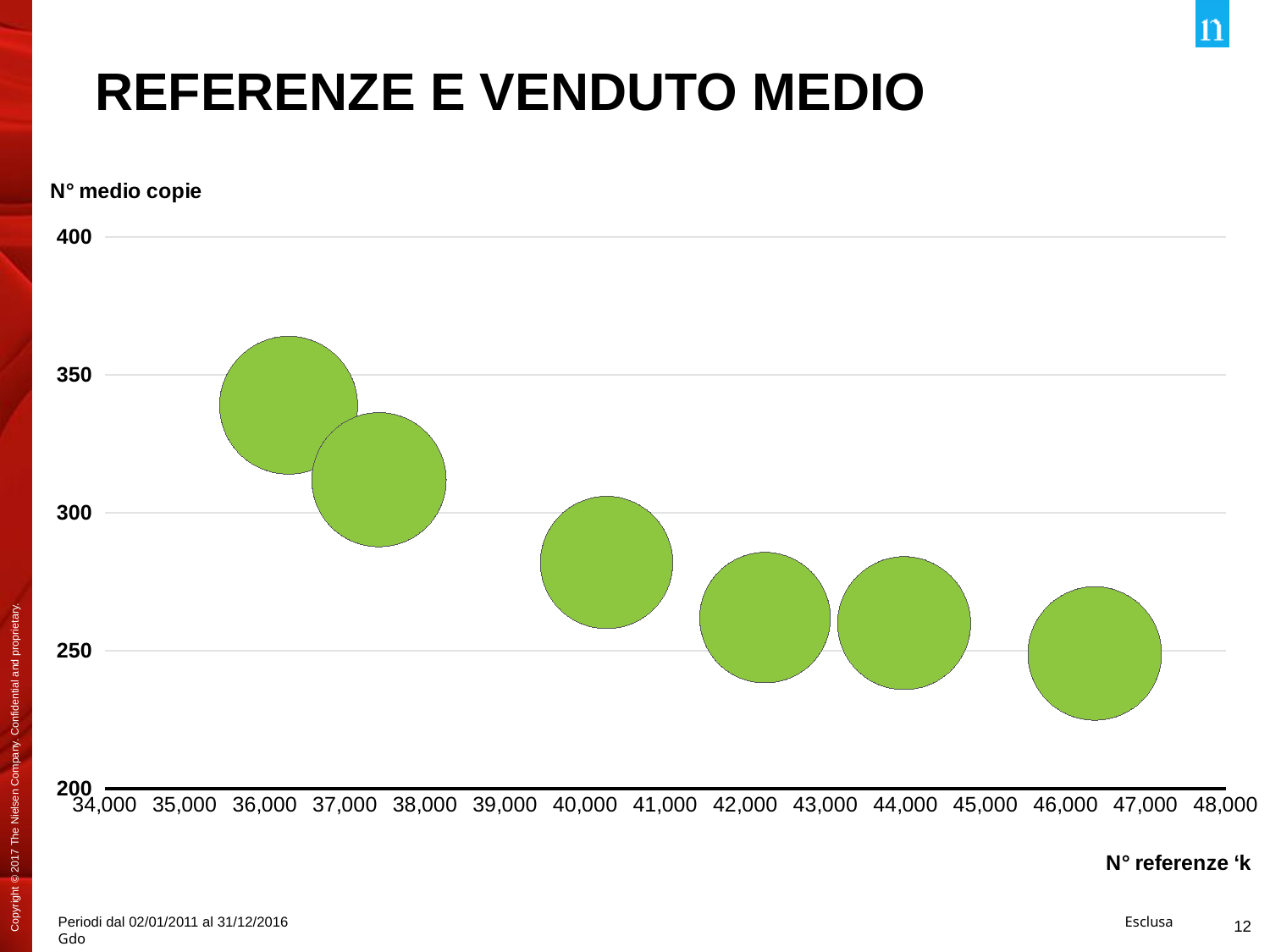
How many bubbles are plotted on the chart? 6 What label is shown on the vertical axis of the chart? N° medio copie As the number of references (N° referenze) increases along the x axis, does the average number of copies (N° medio copie) rise or fall? fall Is the N° medio copie value for the leftmost bubble greater or less than 350? less Is the N° referenze value for the leftmost bubble greater or less than 37,000? less Which bubble has the highest N° medio copie value, the leftmost or the rightmost? the leftmost What kind of chart is shown on the slide? bubble chart What is the title of the chart on the slide? REFERENZE E VENDUTO MEDIO Is the N° medio copie value for the third bubble from the left greater or less than 300? less